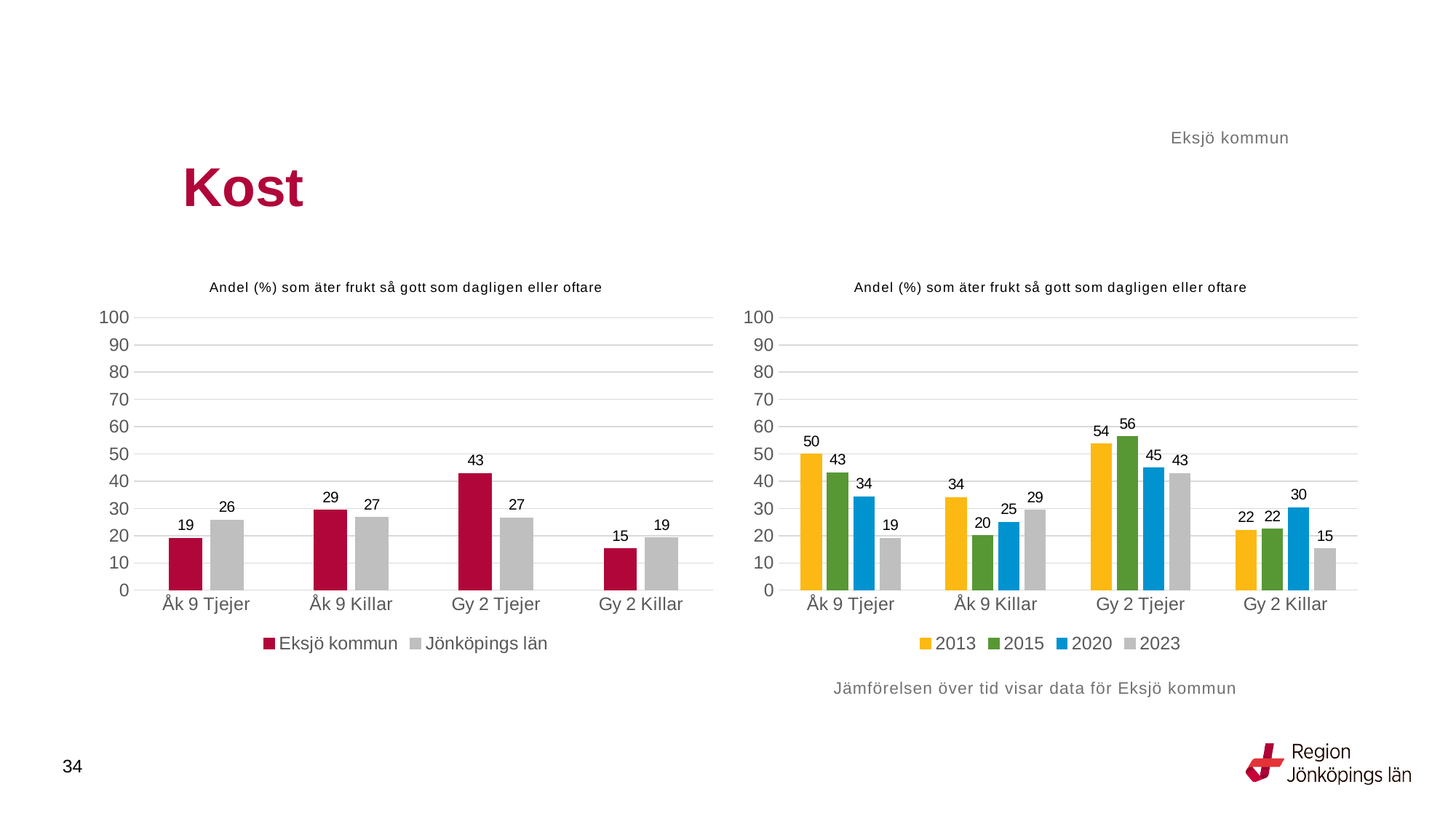
What kind of chart is the right chart? Bar chart In the left chart, what is the difference between Eksjö kommun and Jönköpings län for Gy 2 Tjejer? 16 In the right chart, what is the value for 2020 for Gy 2 Killar? 30 How many series does the legend of the right chart list? 4 How many series does the legend of the left chart list? 2 In the left chart, what is the value for Jönköpings län for Åk 9 Tjejer? 26 In the left chart, which is larger for Åk 9 Tjejer: Eksjö kommun or Jönköpings län? Jönköpings län In the left chart, what is the value for Eksjö kommun for Gy 2 Tjejer? 43 In the right chart, which year has the highest value for Åk 9 Tjejer? 2013 In the right chart, what is the difference between 2013 and 2023 for Åk 9 Tjejer? 31 In the left chart, which category has the lowest value for Eksjö kommun? Gy 2 Killar In the right chart, what is the value for 2015 for Gy 2 Tjejer? 56